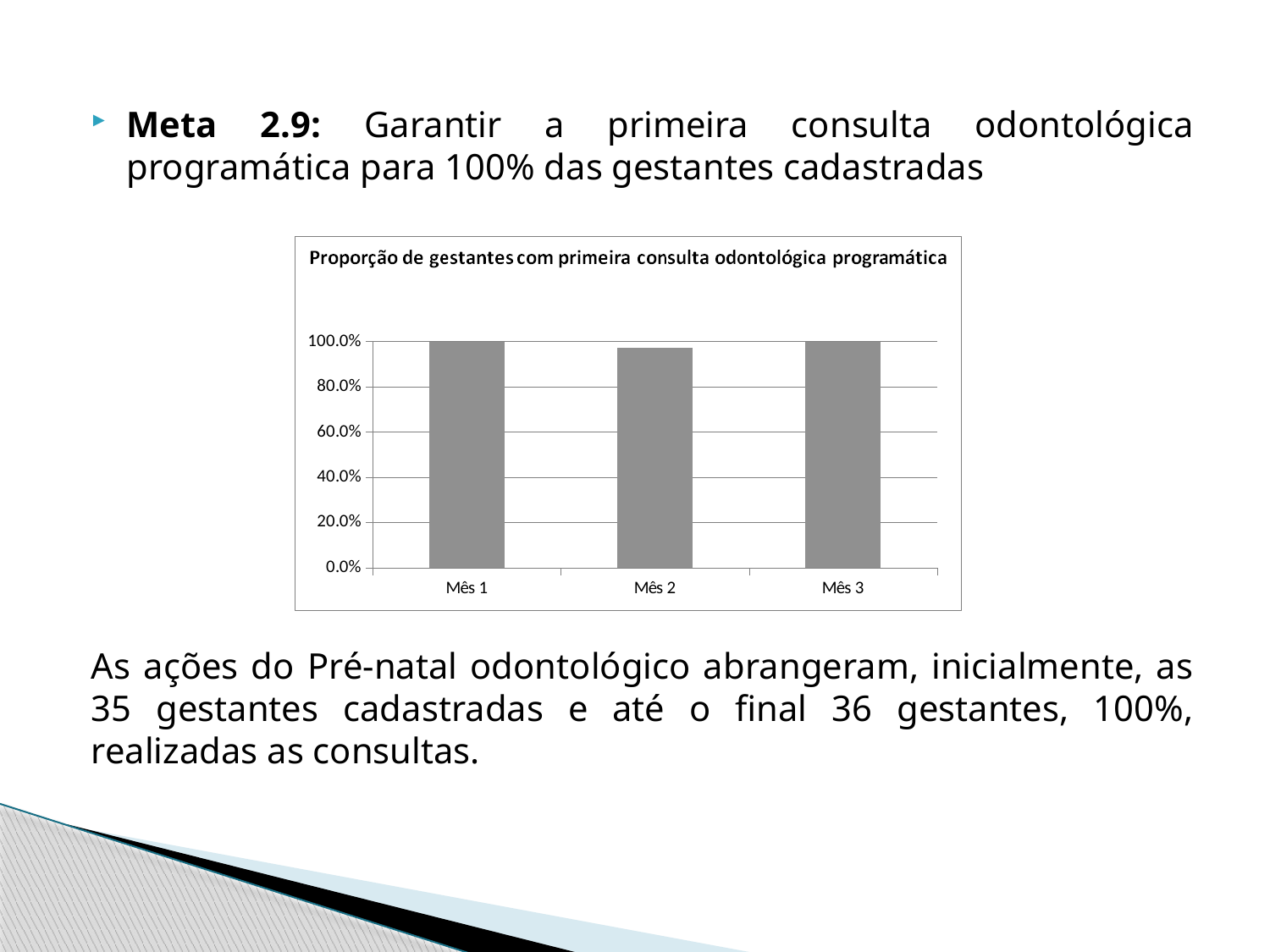
What is the label of the first category on the x axis? Mês 1 What is the value for Mês 1? 100.0% What kind of chart is shown on the slide? bar chart Which is larger, the value for Mês 1 or the value for Mês 2? Mês 1 Which is larger, the value for Mês 2 or the value for Mês 3? Mês 3 Is the value for Mês 2 greater or less than 100.0%? less Is the value for Mês 2 greater or less than 80.0%? greater What is the title of the chart? Proporção de gestantes com primeira consulta odontológica programática Which month has the lowest value on the chart? Mês 2 What is the value for Mês 3? 100.0% What is the highest tick value shown on the y axis? 100.0% How many categories (months) are plotted on the chart? 3